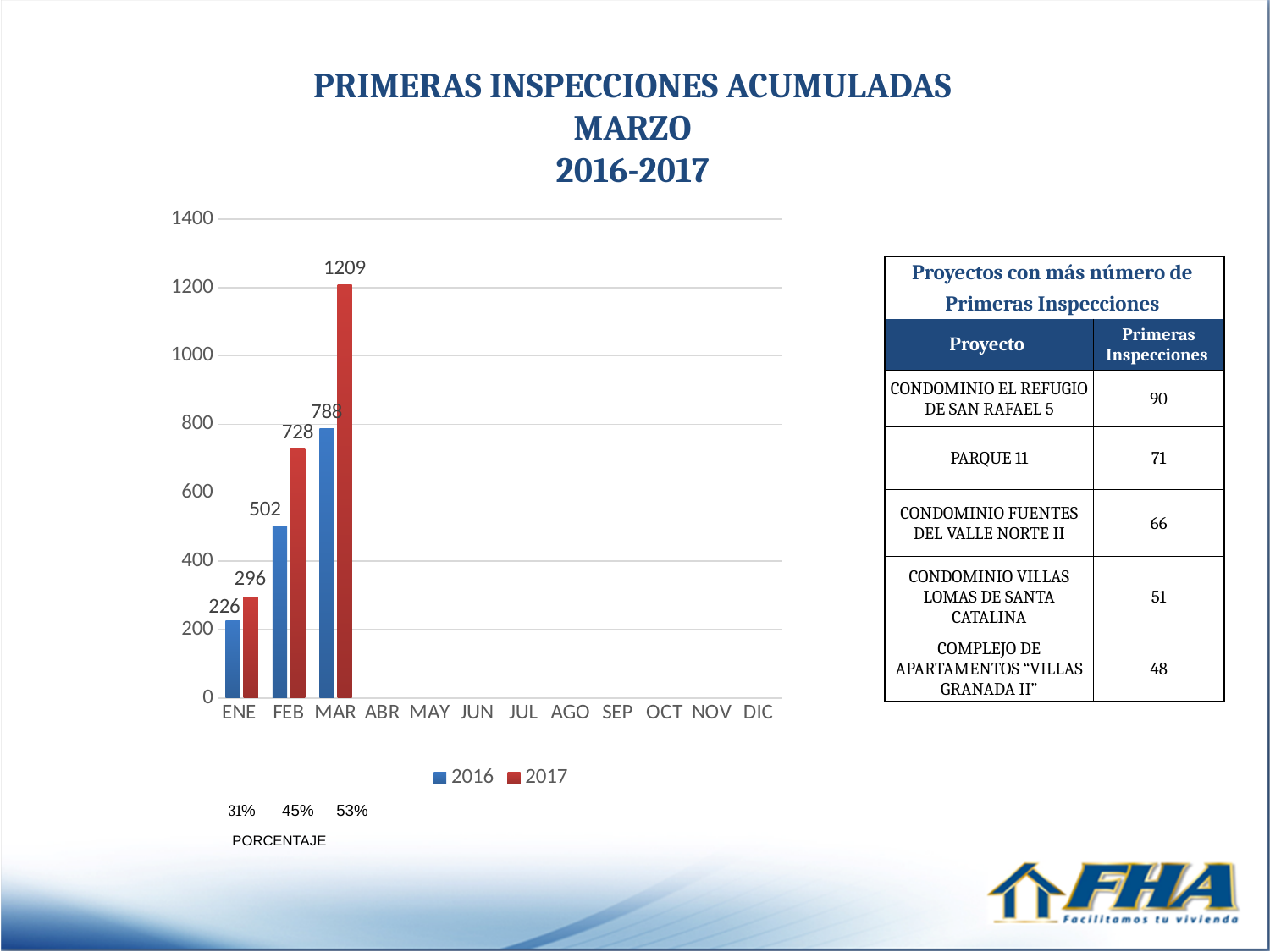
What is the value for 2017 in FEB? 728 What is the value for 2017 in MAR? 1209 What is the value for 2016 in MAR? 788 How many series does the legend list? 2 What is the difference between the 2017 and 2016 values in MAR? 421 Do the 2016 values rise or fall from ENE to MAR? rise Is the value for 2017 in ENE greater or less than 400? less Which month has the highest value for the 2017 series? MAR Which month has the lowest value for the 2016 series among the months with data? ENE What is the value for 2016 in ENE? 226 Which is larger in FEB, the 2016 value or the 2017 value? 2017 What kind of chart is shown on the slide? bar chart